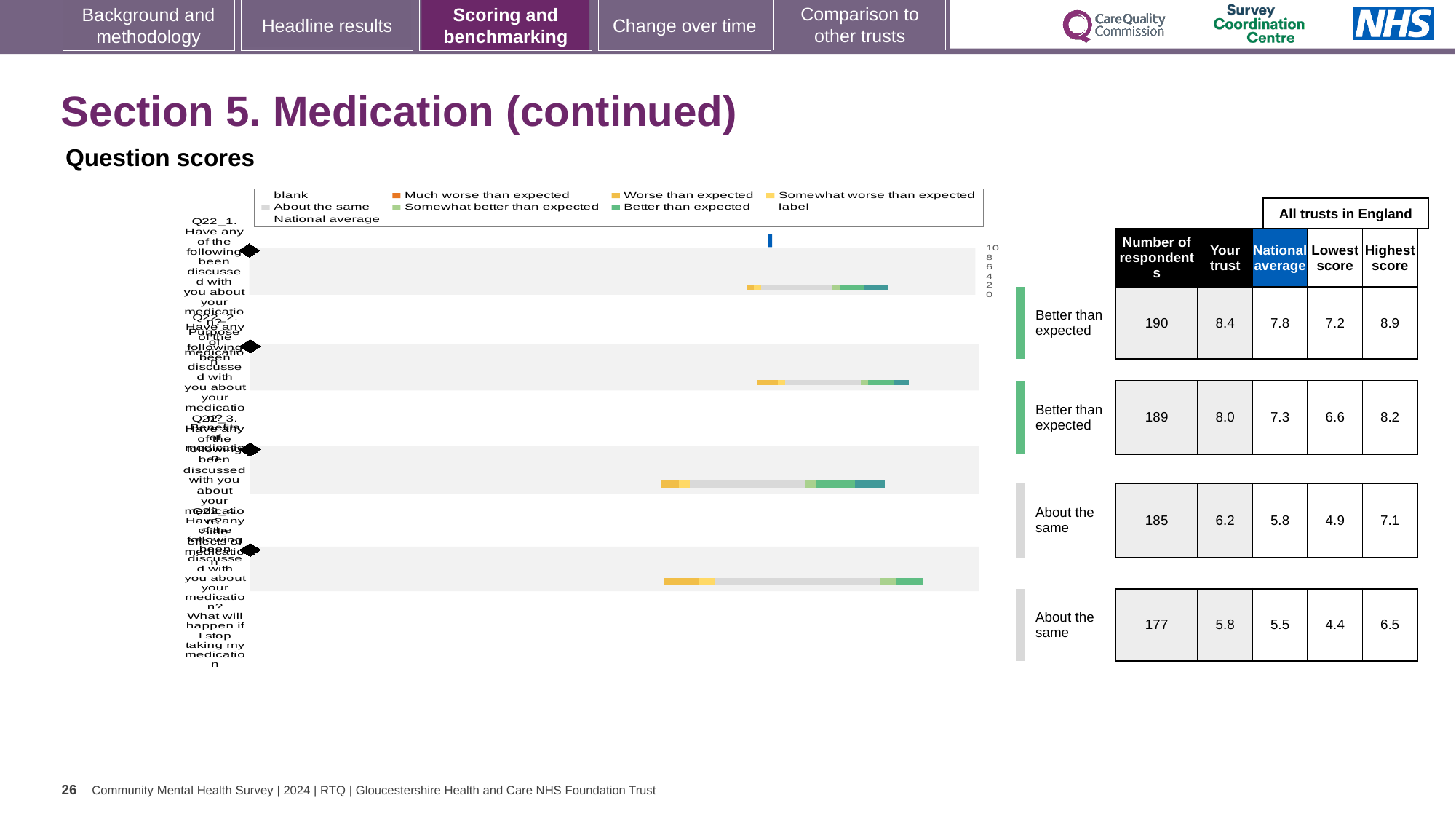
For the third row, which is larger: the 'Your trust' score or the national average? Your trust (6.2) Which row has the lowest number of respondents in the table? the fourth (bottom) row, 177 In the table, what is the 'Your trust' score for the second row? 8.0 What kind of chart is shown on the slide? bar chart What is the lowest score across all trusts in England for the fourth row? 4.4 Which row has the highest 'Your trust' score in the table? the first (top) row, 8.4 For the first row, what is the difference between the 'Your trust' score and the national average? 0.6 What benchmark category is shown for the first row of the chart? Better than expected How many question rows (bars) are plotted in the chart? 4 What is the highest score across all trusts in England for the third row? 7.1 What heading appears above the Lowest score and Highest score columns of the table? All trusts in England In the table, what is the number of respondents for the first (top) row? 190